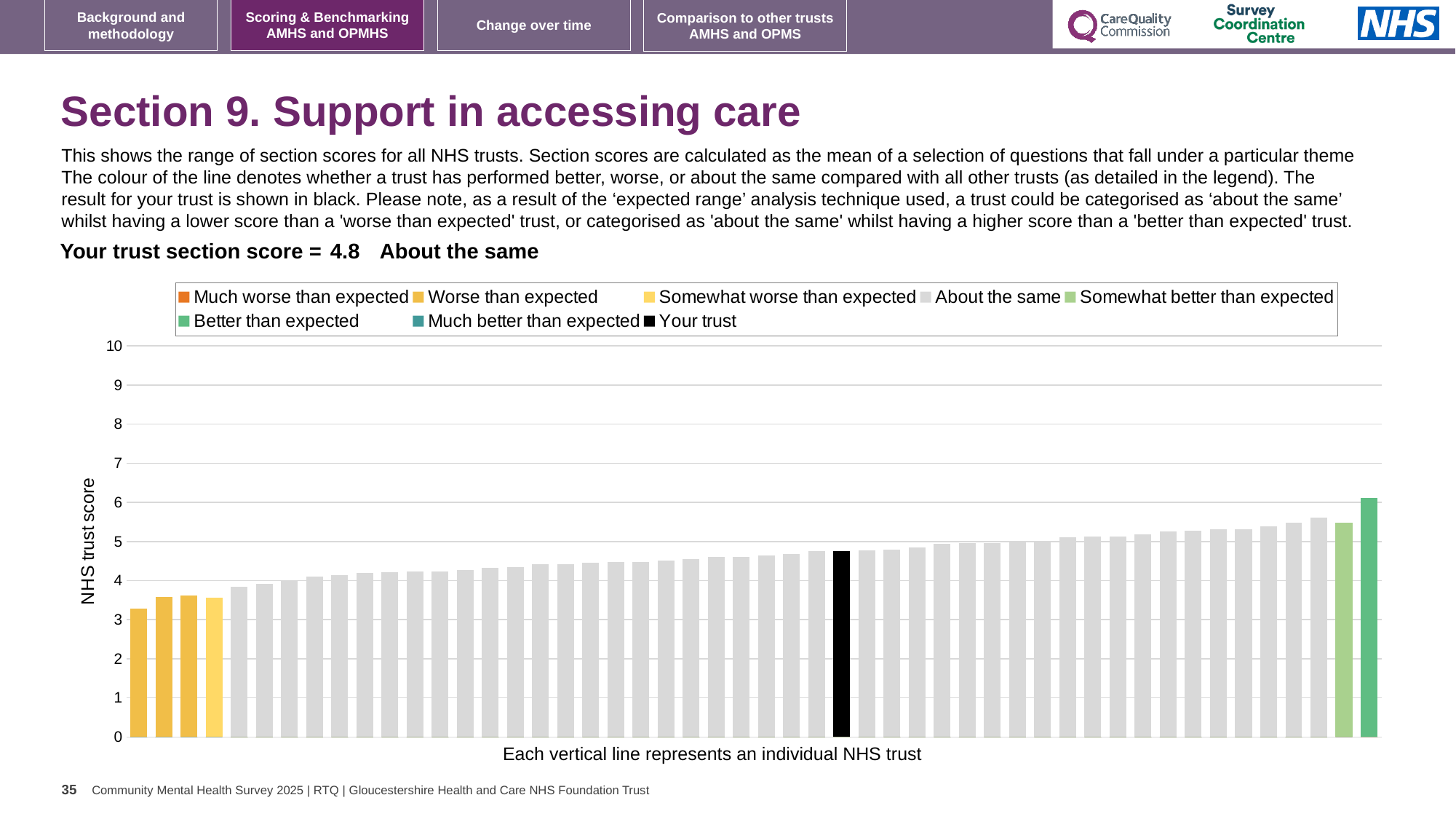
Is the value of the black 'Your trust' bar greater or less than 4? greater Is the value of the lowest bar greater or less than 3? greater Is the value of the black 'Your trust' bar greater or less than 5? less What is the section score for your trust shown on the slide? 4.8 How many bars are coloured yellow (Worse than expected)? 3 What is the label on the vertical axis of the chart? NHS trust score What kind of chart is shown on the slide? bar chart Which category is your trust placed in for this section? About the same Do the bar values rise or fall from left to right along the x axis? rise How many entries does the chart legend list? 8 Which legend category does the tallest bar belong to? Better than expected